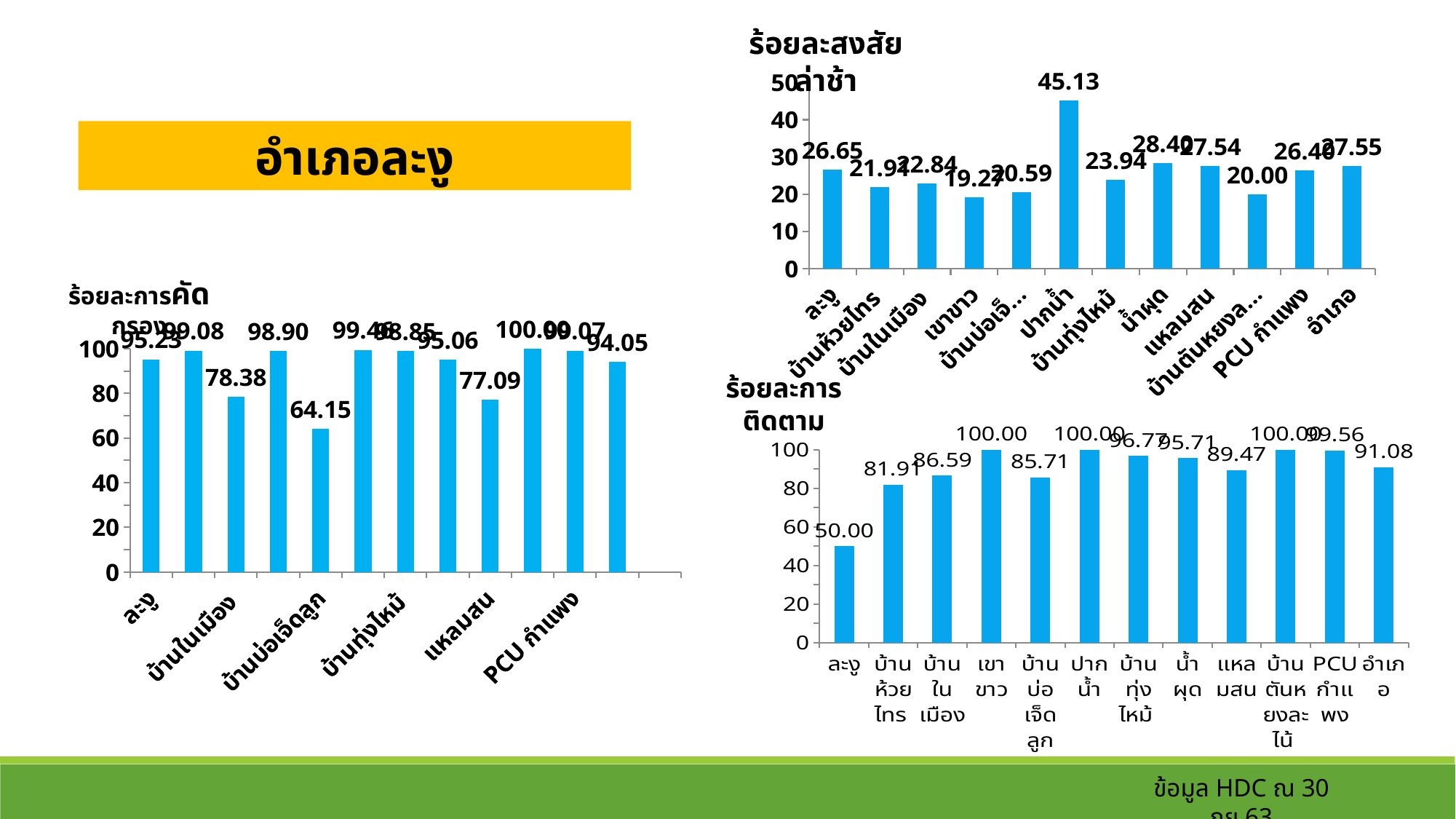
In the chart titled ร้อยละสงสัยล่าช้า, what is the value for ละงู? 26.65 In the chart titled ร้อยละการคัดกรอง, what is the value for บ้านในเมือง? 78.38 In the chart titled ร้อยละสงสัยล่าช้า, which category has the highest value? ปากน้ำ In the chart titled ร้อยละการคัดกรอง, what is the value for บ้านบ่อเจ็ดลูก? 64.15 What kind of chart is the chart titled ร้อยละการคัดกรอง? bar chart In the chart titled ร้อยละการติดตาม, how many categories are shown on the x axis? 12 In the chart titled ร้อยละการติดตาม, which is larger, the value for แหลมสน or the value for อำเภอ? อำเภอ In the chart titled ร้อยละการติดตาม, which category has the lowest value? ละงู In the chart titled ร้อยละการติดตาม, what is the value for บ้านห้วยไทร? 81.91 In the chart titled ร้อยละสงสัยล่าช้า, what is the value for ปากน้ำ? 45.13 In the chart titled ร้อยละสงสัยล่าช้า, which category has the lowest value? เขาขาว In the chart titled ร้อยละสงสัยล่าช้า, what is the difference between the values for ปากน้ำ and เขาขาว? 25.86